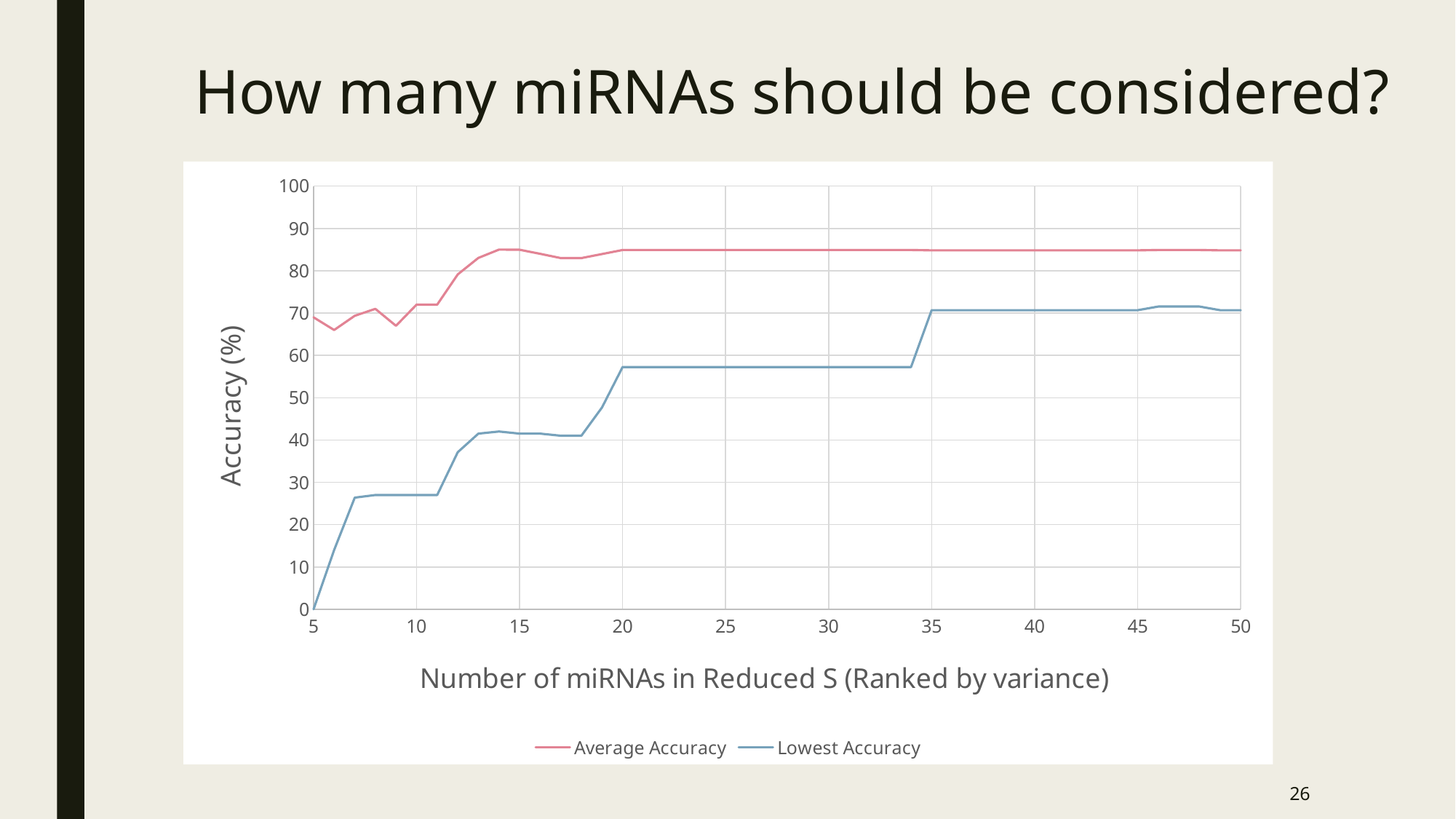
What kind of chart is shown on the slide? line chart Is the Lowest Accuracy value at 10 miRNAs greater or less than 30? less What are the two series named in the legend? Average Accuracy and Lowest Accuracy Is the Lowest Accuracy value at 50 miRNAs greater or less than 60? greater At 30 miRNAs, which series has the higher value, Average Accuracy or Lowest Accuracy? Average Accuracy What is the x-axis title of the chart? Number of miRNAs in Reduced S (Ranked by variance) Is the Lowest Accuracy value at 25 miRNAs greater or less than 60? less Does the Lowest Accuracy series generally rise or fall as the number of miRNAs increases from 5 to 50? rise What is the Lowest Accuracy value at 5 miRNAs? 0 How many series does the legend list? 2